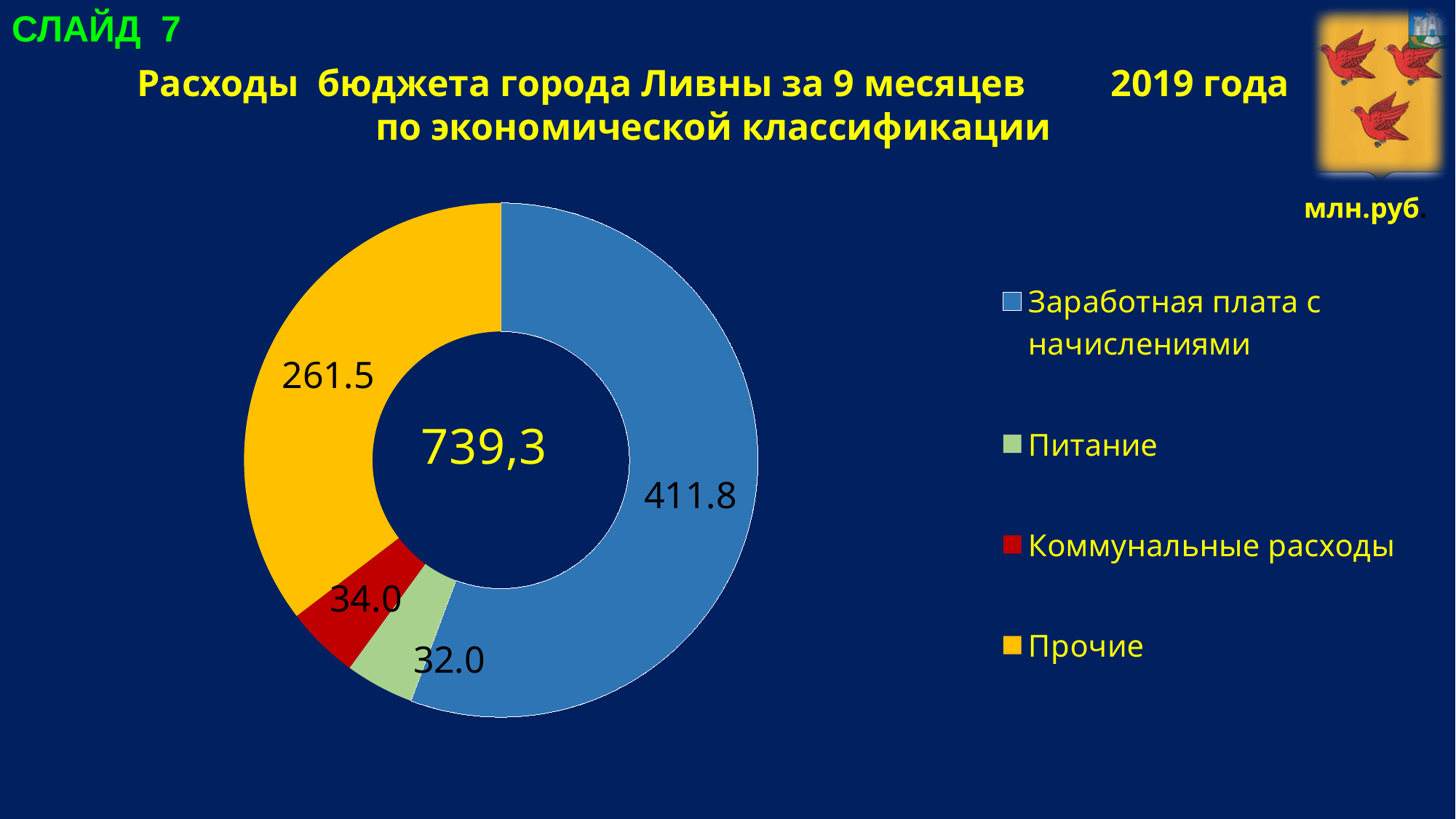
What is the value for Заработная плата с начислениями? 411.8 What is the value for Прочие? 261.5 Which is larger, Коммунальные расходы or Питание? Коммунальные расходы Which category has the smallest value? Питание What is the difference between Заработная плата с начислениями and Прочие? 150.3 What is the value for Питание? 32.0 What unit is indicated for the chart values? млн.руб. What total is shown in the centre of the chart? 739,3 What kind of chart is shown on the slide? doughnut chart What is the value for Коммунальные расходы? 34.0 How many categories does the chart show? 4 Which category has the largest value? Заработная плата с начислениями